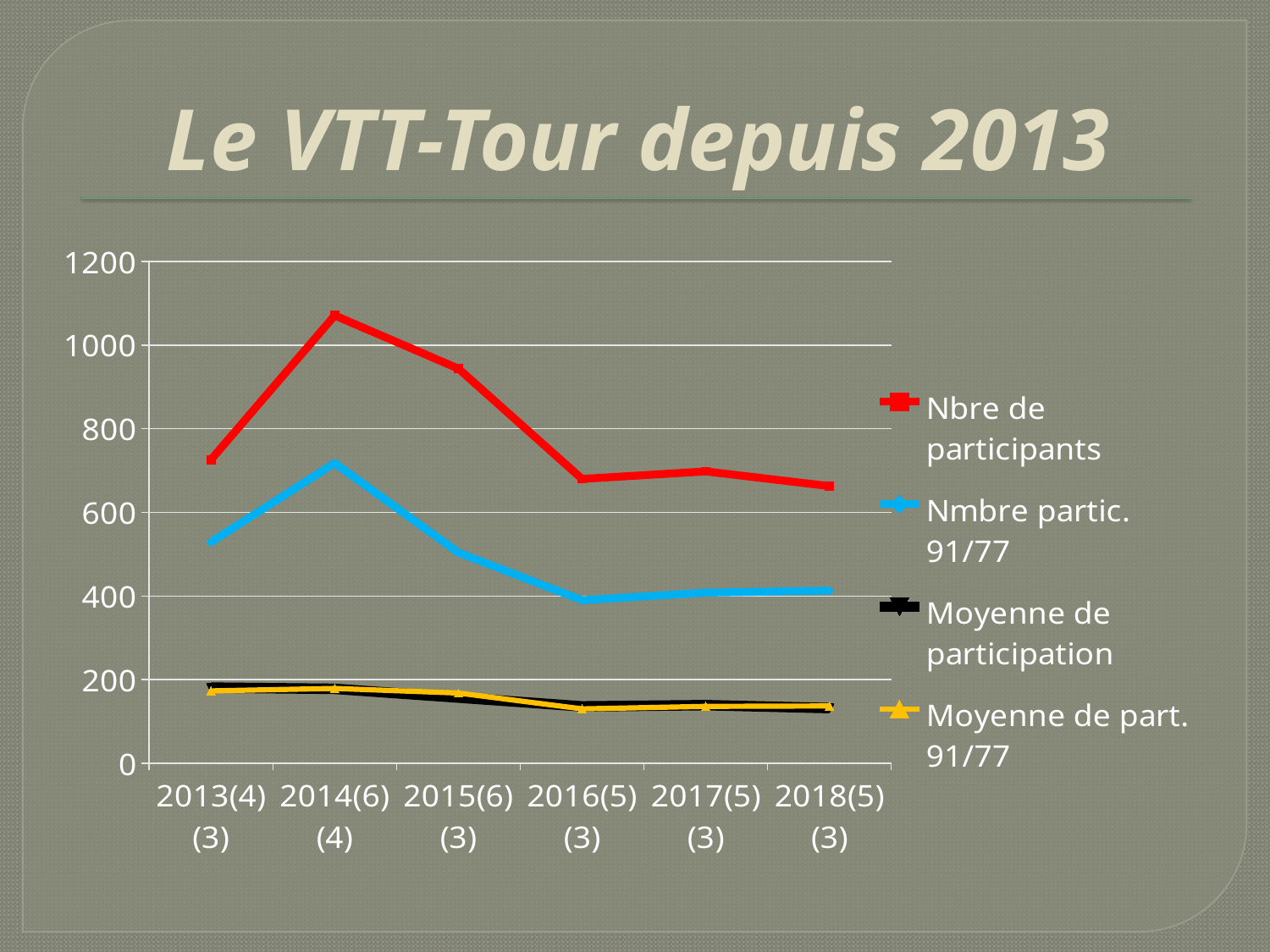
How many categories are shown on the x axis? 6 Is the value of 'Nmbre partic. 91/77' for 2016(5) (3) greater or less than 600? less What kind of chart is shown on the slide? line chart Is the value of 'Nbre de participants' for 2013(4) (3) greater or less than 800? less What is the title of the slide? Le VTT-Tour depuis 2013 In which category does the 'Nbre de participants' series reach its highest value? 2014(6) (4) Is the value of 'Nbre de participants' for 2014(6) (4) greater or less than 1000? greater In which category does the 'Nmbre partic. 91/77' series reach its highest value? 2014(6) (4) For 2015(6) (3), which series has the larger value: 'Nbre de participants' or 'Nmbre partic. 91/77'? Nbre de participants How many series does the legend list? 4 What colour is the line for 'Nbre de participants'? red Does the 'Nbre de participants' series rise or fall from 2014(6) (4) to 2016(5) (3)? fall